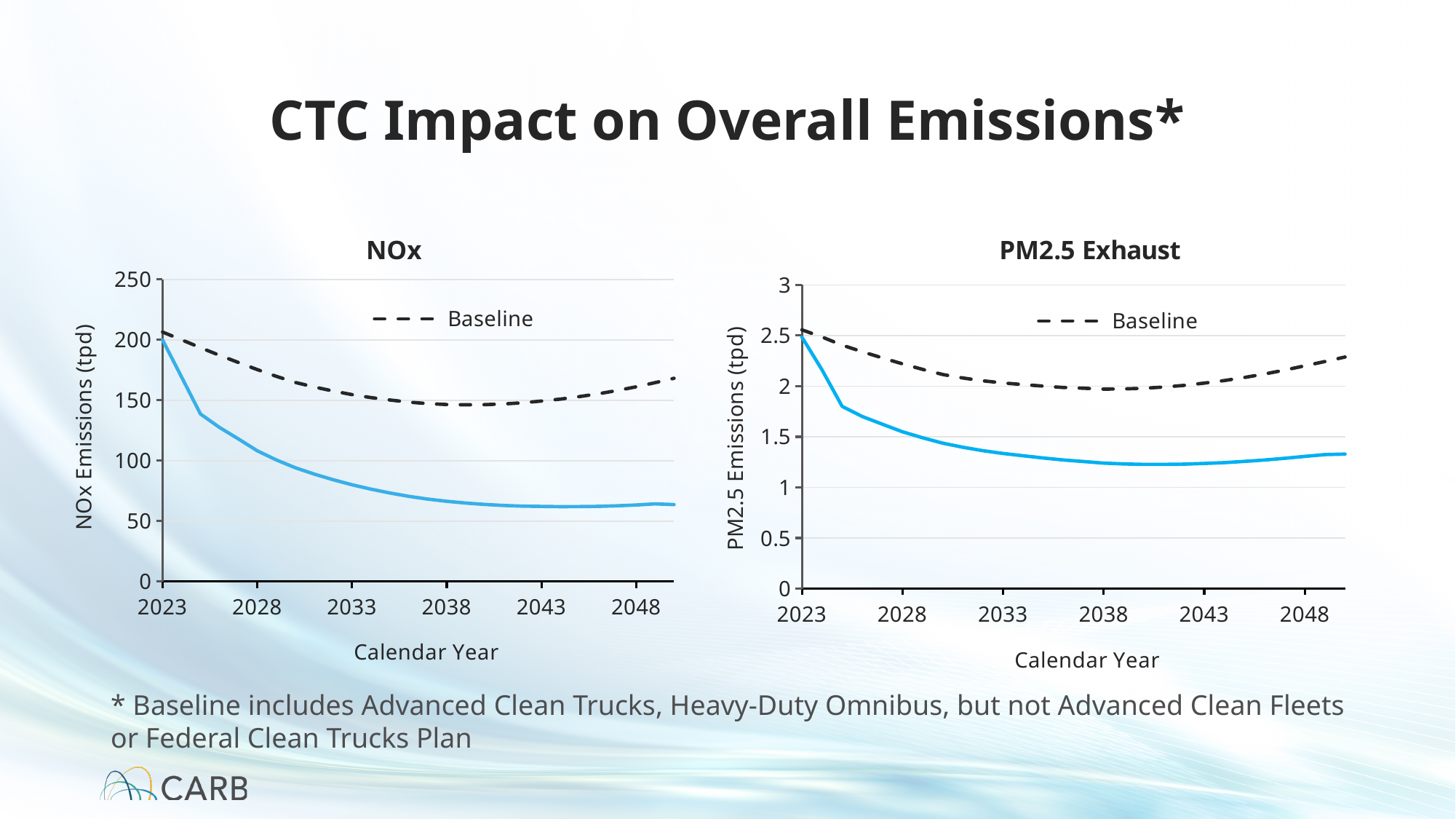
In the NOx chart, how many series does the legend list? 1 In the NOx chart, is the value of the solid blue line in 2033 greater or less than 100? less In the PM2.5 Exhaust chart, is the Baseline value in 2023 greater or less than 2? greater What is the y-axis label of the NOx chart? NOx Emissions (tpd) In the PM2.5 Exhaust chart, which is larger in 2048, the Baseline line or the solid blue line? Baseline In the PM2.5 Exhaust chart, what is the name of the series shown in the legend? Baseline What kind of chart is the PM2.5 Exhaust chart? line chart What kind of chart is the NOx chart? line chart In the NOx chart, does the solid blue line rise or fall between 2023 and 2043? fall In the NOx chart, is the value of the solid blue line in 2048 greater or less than 100? less